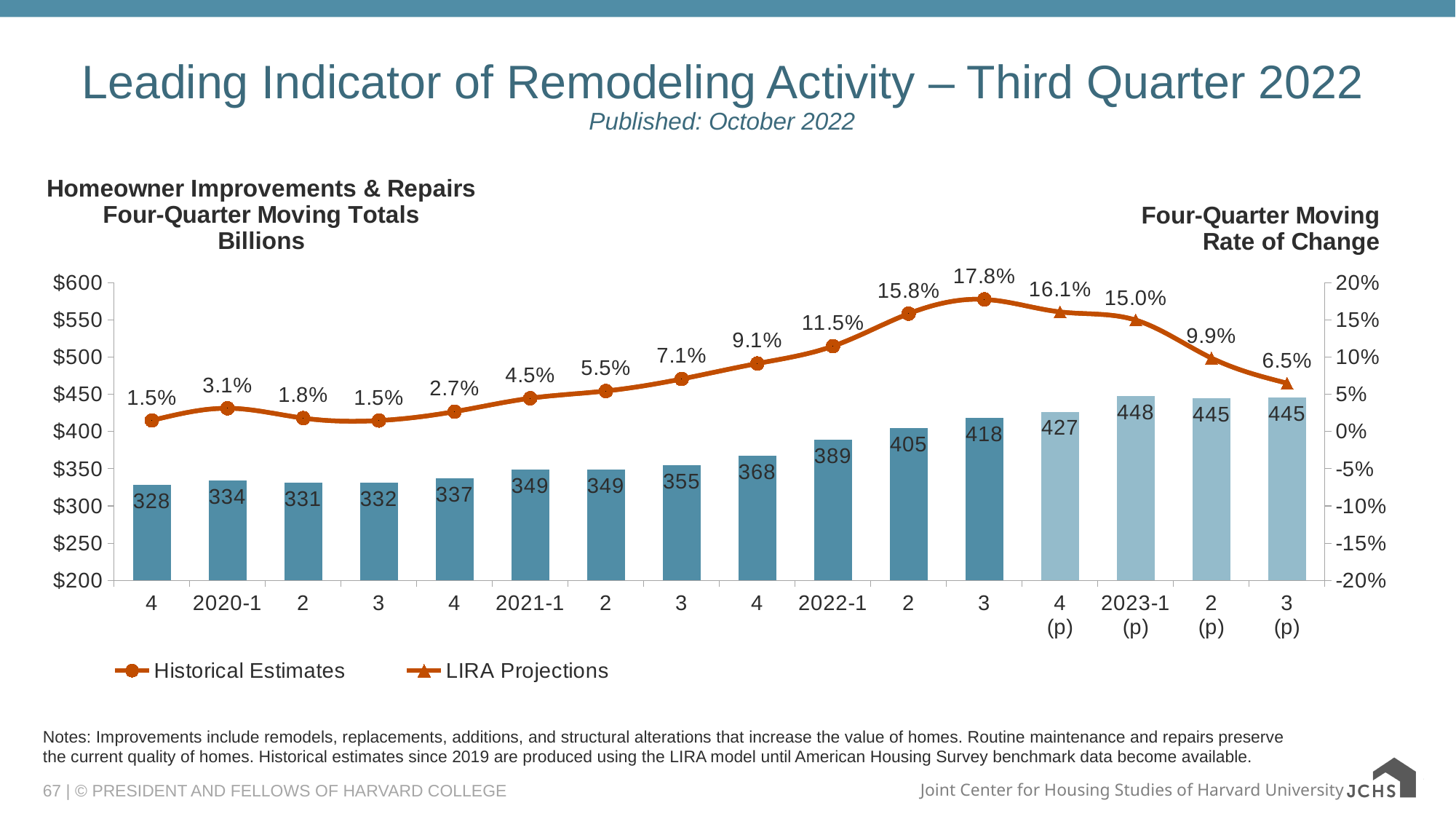
How many series does the legend list? 2 What are the two legend entries for the line series? Historical Estimates and LIRA Projections What kind of chart is shown on the slide? Combined bar and line chart Which quarter has the highest four-quarter moving rate of change? 2022-3 How many bars are plotted in the chart? 16 Which is larger, the rate of change for 2022-4 (p) or for 2023-1 (p)? 2022-4 (p) What is the difference between the four-quarter moving totals for 2023-1 (p) and 2022-3? 30 What is the four-quarter moving total (in billions) for 2022-3? 418 Which quarter has the lowest four-quarter moving total bar? 2019-4 (the first bar, labeled 4) What is the four-quarter moving rate of change for 2022-1? 11.5% Does the four-quarter moving rate of change rise or fall from 2022-3 to 2023-3 (p)? Fall What is the projected four-quarter moving total for 2023-1 (p)? 448